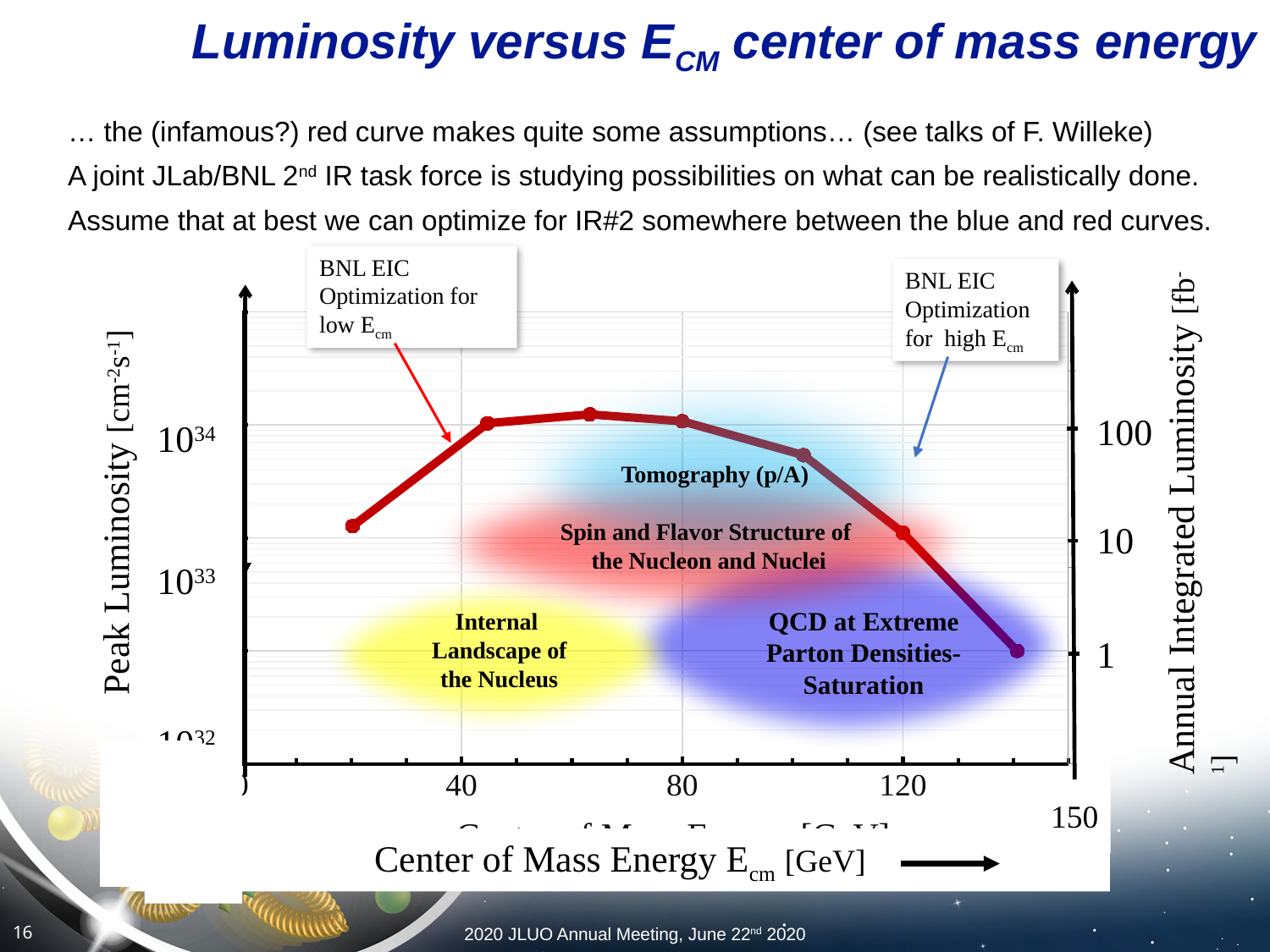
Is the peak luminosity at the highest point of the red curve greater or less than 10^33? greater What is the label of the left y axis? Peak Luminosity [cm-2s-1] Is the peak luminosity at the lowest-energy point of the red curve greater or less than 10^33? greater Is the peak luminosity at the lowest-energy point of the red curve greater or less than 10^34? less Which is larger, the peak luminosity at the lowest-energy point of the red curve or at the highest-energy point? lowest-energy point Does the red curve rise or fall as the center of mass energy increases from 120 GeV toward 150 GeV? fall What is the label of the x axis? Center of Mass Energy Ecm [GeV] Is the lowest point of the red curve at the low-energy end or the high-energy end of the x axis? high-energy end How many data points are marked on the red curve? 7 What kind of chart is shown on the slide? line chart Does the red curve rise or fall as the center of mass energy increases from its lowest-energy point to 40 GeV? rise